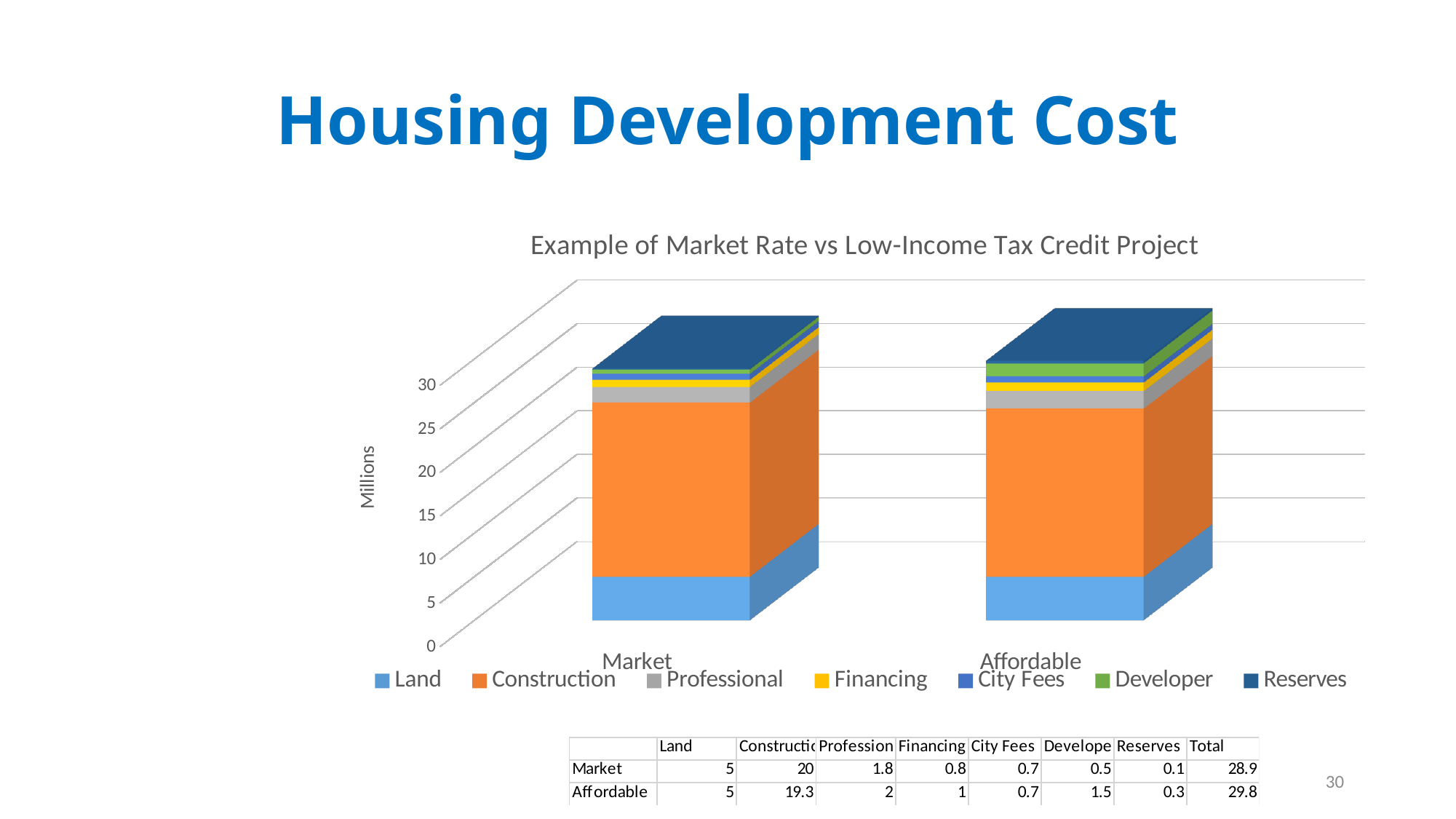
Which series is the smallest component of the Market bar? Reserves What is the Reserves value for the Market project? 0.1 Which series is the largest component of the Market bar? Construction What is the Developer value for the Affordable project? 1.5 What is the difference between the Construction values for Market and Affordable? 0.7 How many categories are plotted on the x axis of the chart? 2 What is the title of the chart? Example of Market Rate vs Low-Income Tax Credit Project How many series does the chart legend list? 7 What is the Construction value for the Market project? 20 What kind of chart is shown on the slide? stacked bar chart Which project has the larger Developer value, Market or Affordable? Affordable What is the total of the stacked bar for the Affordable project? 29.8